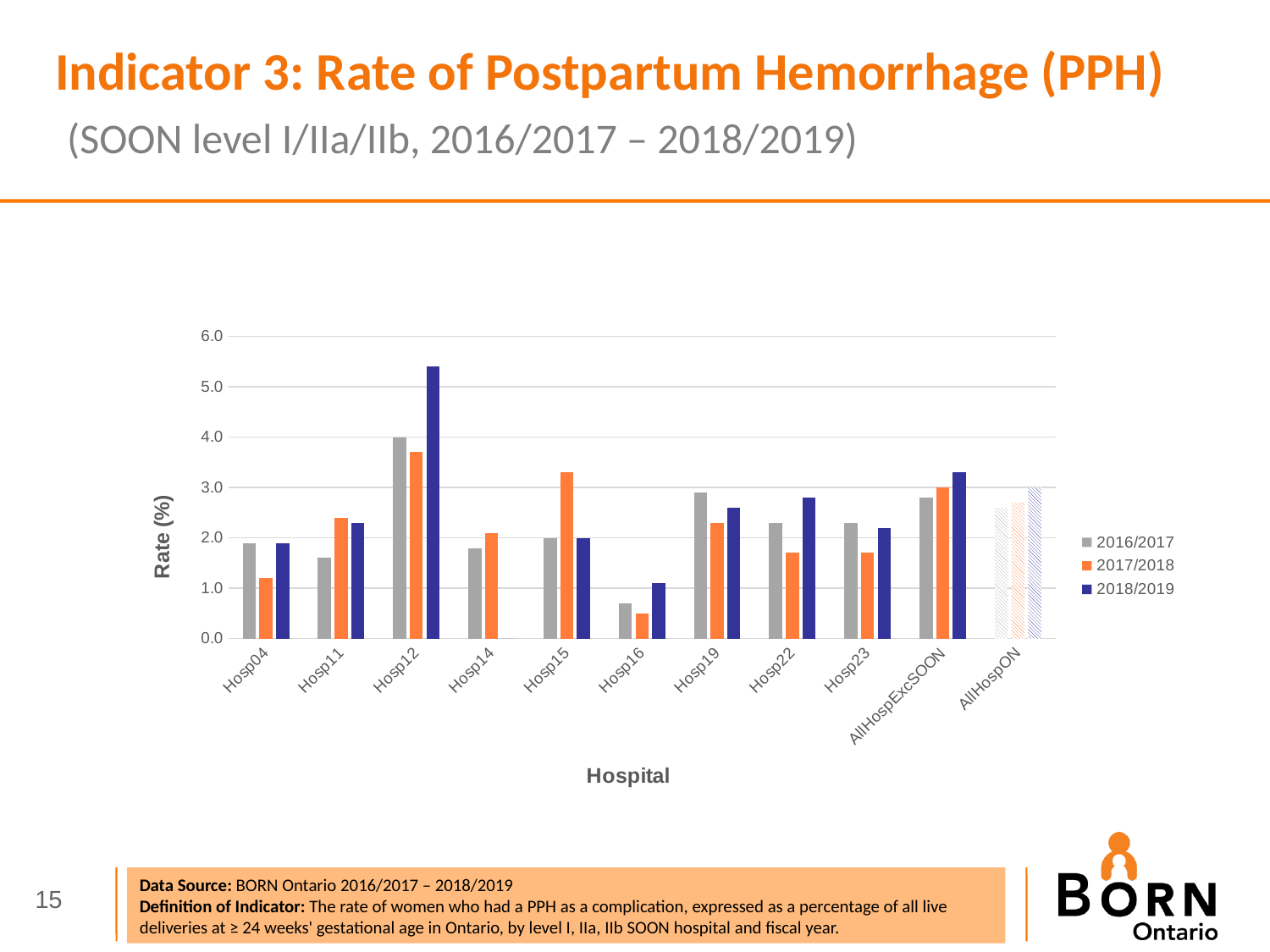
What is the label of the y axis? Rate (%) Is the 2017/2018 value for Hosp15 greater or less than 3.0? greater Is the 2018/2019 value for Hosp12 greater or less than 5.0? greater Is the 2017/2018 value for Hosp16 greater or less than 1.0? less What type of chart is shown on the slide? bar chart For Hosp22, which is larger: the 2017/2018 value or the 2018/2019 value? 2018/2019 For Hosp04, which is larger: the 2016/2017 value or the 2017/2018 value? 2016/2017 How many series does the legend list? 3 How many hospital categories are shown on the x axis? 11 Which hospital has the lowest 2017/2018 PPH rate? Hosp16 Which series is shown in orange in the legend? 2017/2018 Which hospital has the highest 2018/2019 PPH rate? Hosp12